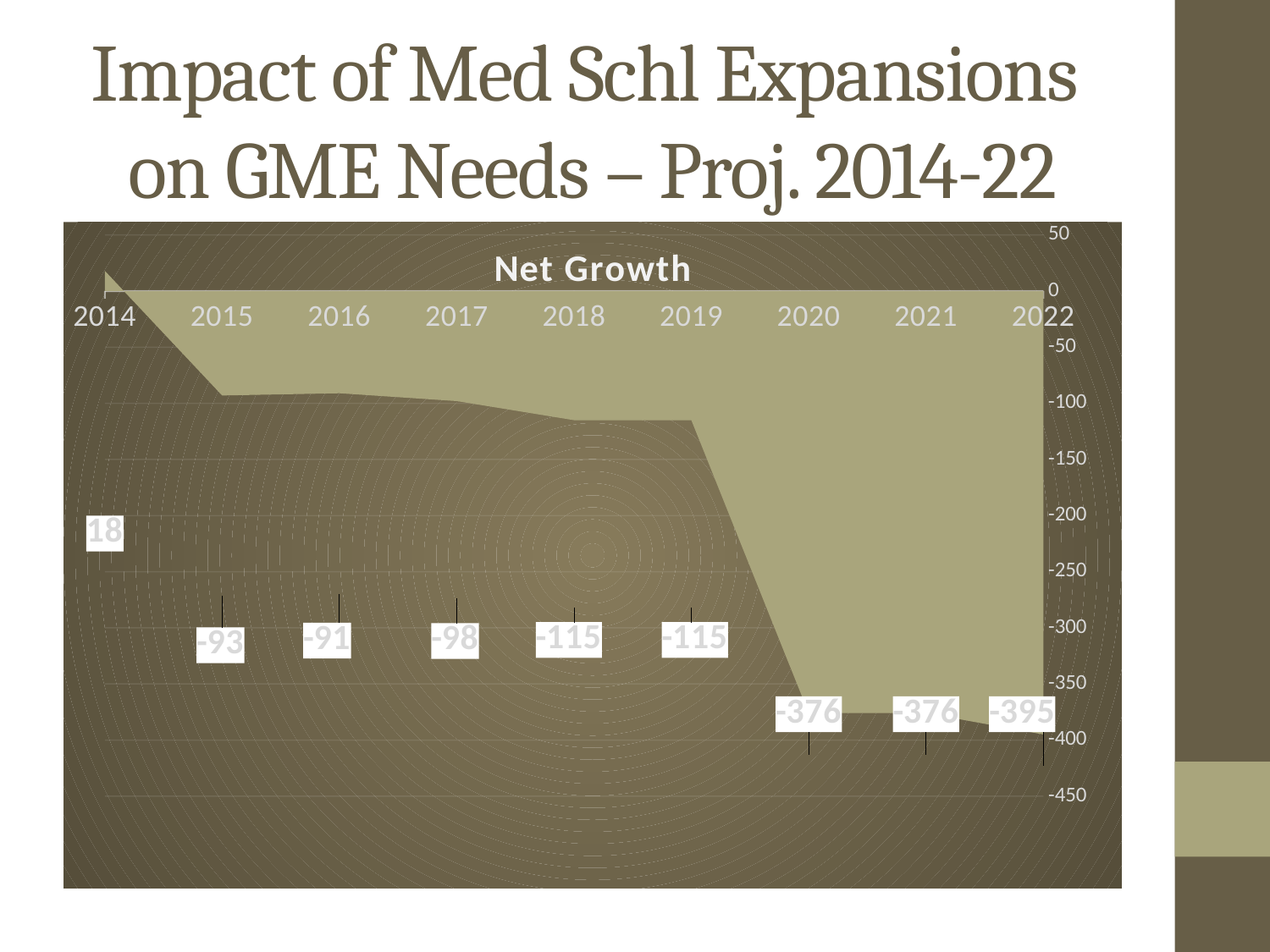
What is the Net Growth value for 2017? -98 What is the Net Growth value for 2022? -395 How many years are plotted on the Net Growth chart? 9 What is the Net Growth value for 2020? -376 Which year has the highest Net Growth value? 2014 What kind of chart is used to show Net Growth? Area chart Which year has the larger Net Growth value, 2015 or 2018? 2015 What is the Net Growth value for 2014? 18 What is the title of the chart on the slide? Net Growth Which year has the lowest Net Growth value? 2022 What is the difference between the Net Growth values for 2019 and 2020? 261 Do the Net Growth values generally rise or fall from 2014 to 2022? Fall